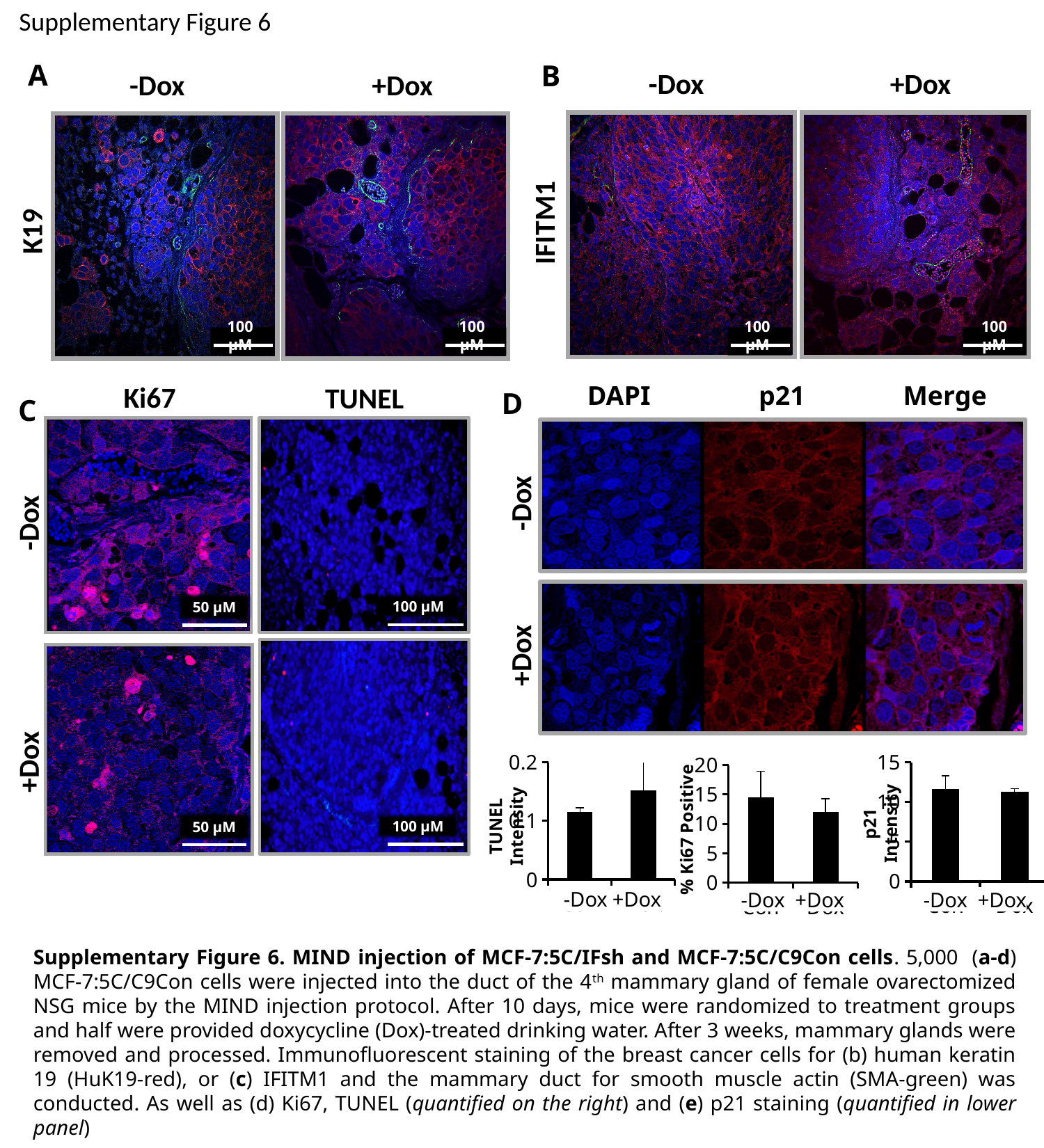
In the % Ki67 Positive chart, which condition has the lower bar? +Dox In the p21 Intensity chart, is the value for +Dox greater or less than 15? less What kind of chart is the TUNEL Intensity chart? bar chart In the TUNEL Intensity chart, which condition has the higher bar? +Dox In the % Ki67 Positive chart, which is larger, the -Dox bar or the +Dox bar? -Dox How many bars does the % Ki67 Positive chart show? 2 What is the label on the y axis of the middle bar chart? % Ki67 Positive In the p21 Intensity chart, is the value for -Dox greater or less than 10? greater In the % Ki67 Positive chart, is the value for +Dox greater or less than 15? less